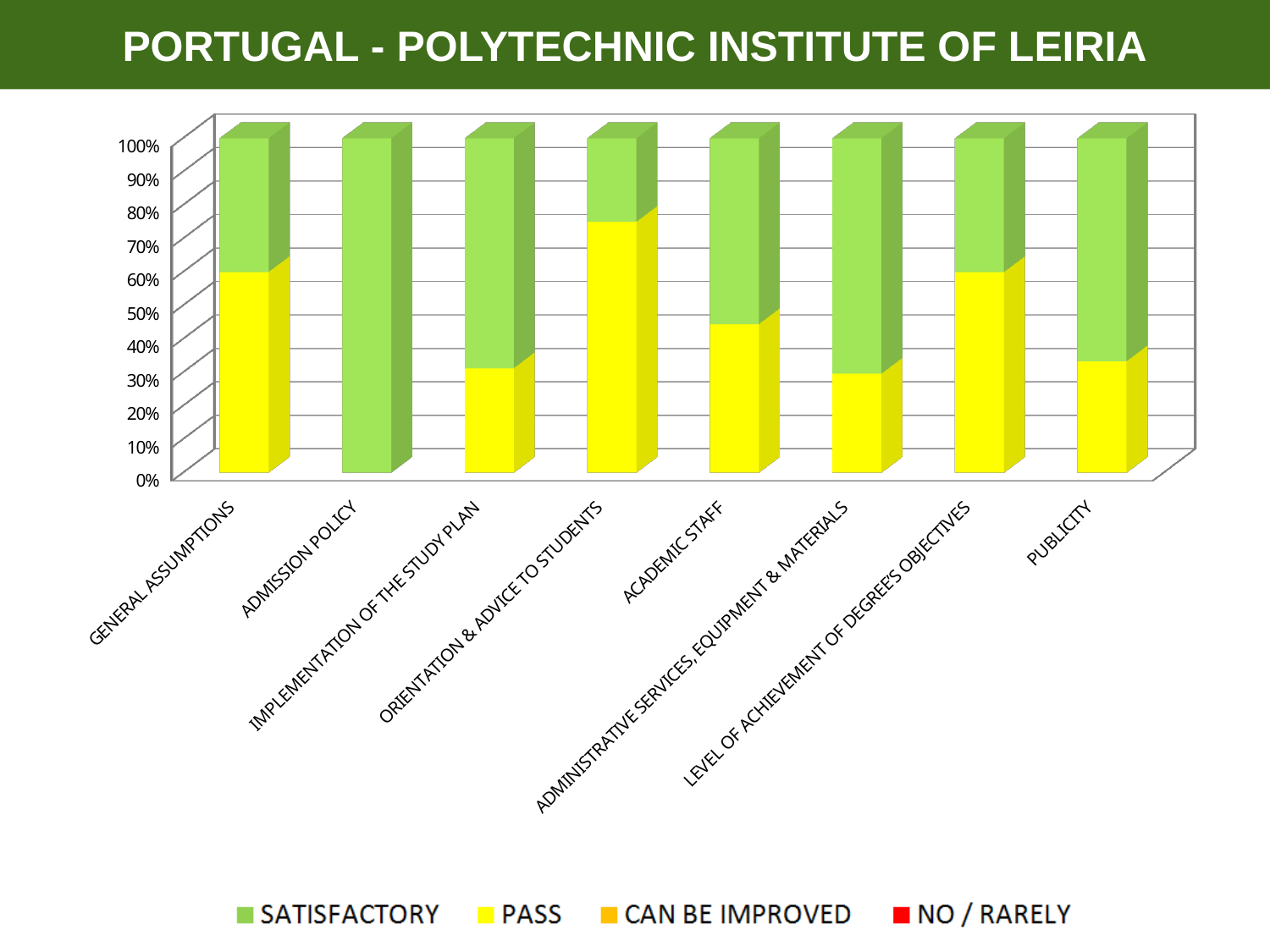
Is the PASS share for GENERAL ASSUMPTIONS greater or less than 50%? greater Which category has the smallest PASS share? ADMISSION POLICY Which colour represents the PASS series in the chart? Yellow What is the title of the slide containing the chart? PORTUGAL - POLYTECHNIC INSTITUTE OF LEIRIA How many series does the chart's legend list? 4 Which category has the largest PASS share? ORIENTATION & ADVICE TO STUDENTS Is the PASS share for ADMINISTRATIVE SERVICES, EQUIPMENT & MATERIALS greater or less than 40%? less What kind of chart is shown on the slide? Stacked bar chart Is the PASS share for ACADEMIC STAFF greater or less than 50%? less Which has the larger PASS share, GENERAL ASSUMPTIONS or ACADEMIC STAFF? GENERAL ASSUMPTIONS What is the SATISFACTORY share for ADMISSION POLICY? 100% How many categories are shown along the x axis of the chart? 8